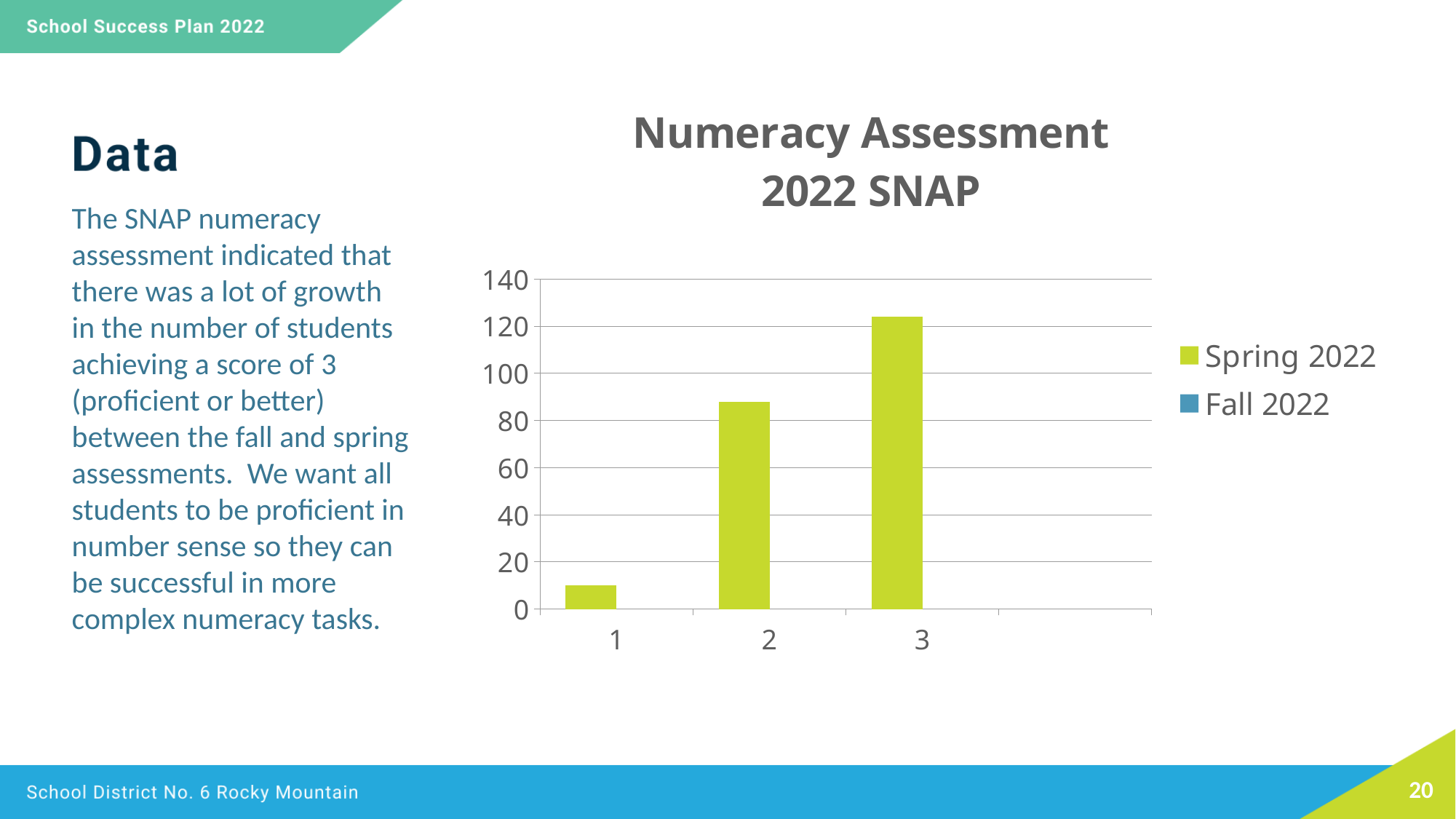
Is the Spring 2022 value for category 3 greater or less than 100? greater Which category has the highest Spring 2022 value? 3 Which category has the lowest Spring 2022 value? 1 Which series is shown in green in the legend? Spring 2022 How many series does the legend list? 2 What is the title of the chart? Numeracy Assessment 2022 SNAP Is the Spring 2022 value for category 2 greater or less than 100? less Do the Spring 2022 values rise or fall from category 1 to category 3? rise Is the Spring 2022 value for category 1 greater or less than 20? less How many categories are shown on the x axis? 3 What kind of chart is shown on the slide? bar chart Which has the larger Spring 2022 value, category 2 or category 1? 2